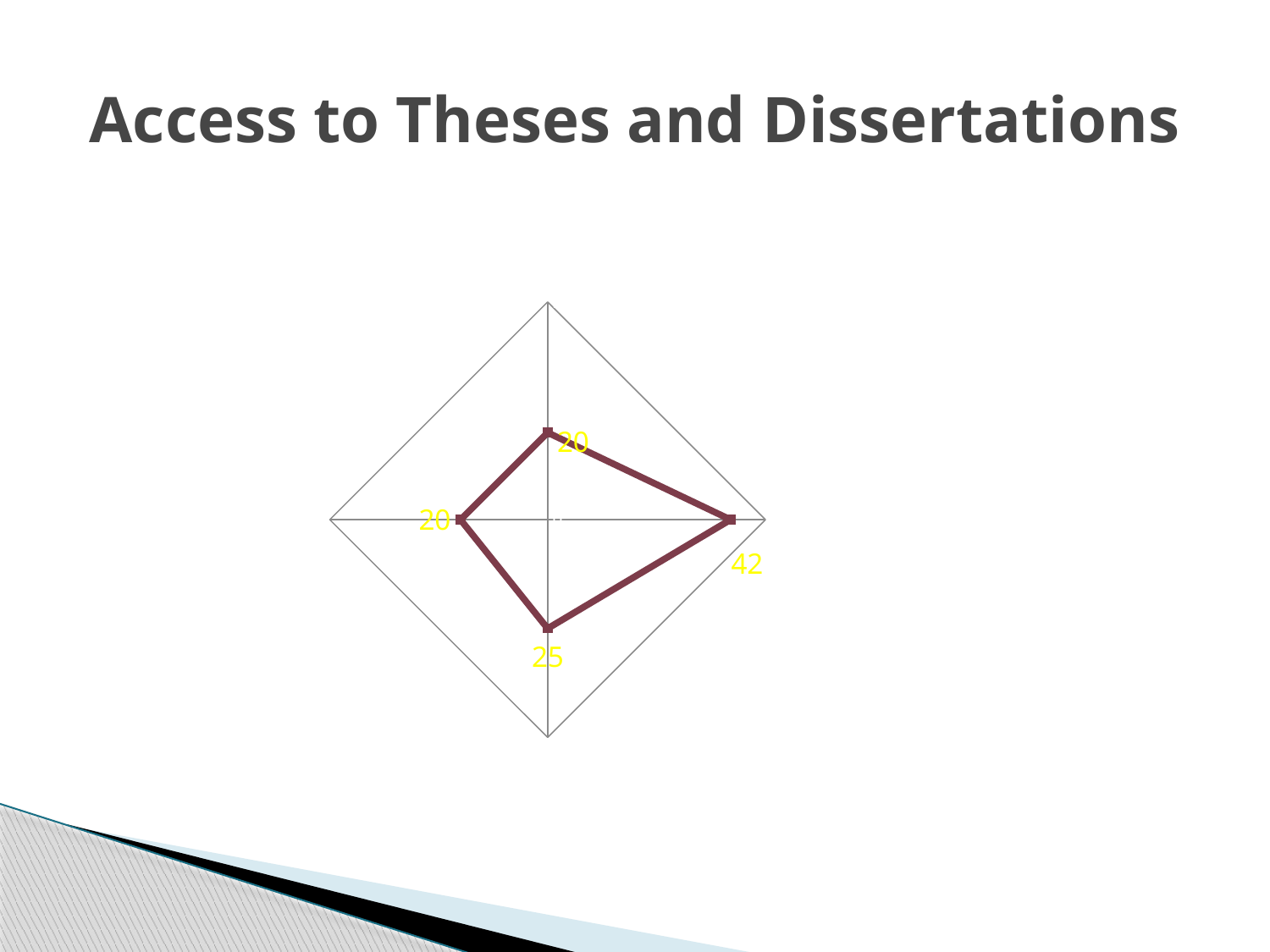
What is the value of the data point on the left axis of the radar chart? 20 What is the value of the data point on the top axis of the radar chart? 20 Which is larger on the radar chart, the right-axis value or the bottom-axis value? the right-axis value What is the difference between the right-axis value and the bottom-axis value on the radar chart? 17 How many data points are plotted on the radar chart? 4 What is the lowest value plotted on the radar chart? 20 What kind of chart is shown on the slide? radar chart What is the difference between the bottom-axis value and the top-axis value on the radar chart? 5 What is the value of the data point on the right axis of the radar chart? 42 What is the highest value plotted on the radar chart? 42 What is the title shown above the chart on the slide? Access to Theses and Dissertations What is the value of the data point on the bottom axis of the radar chart? 25